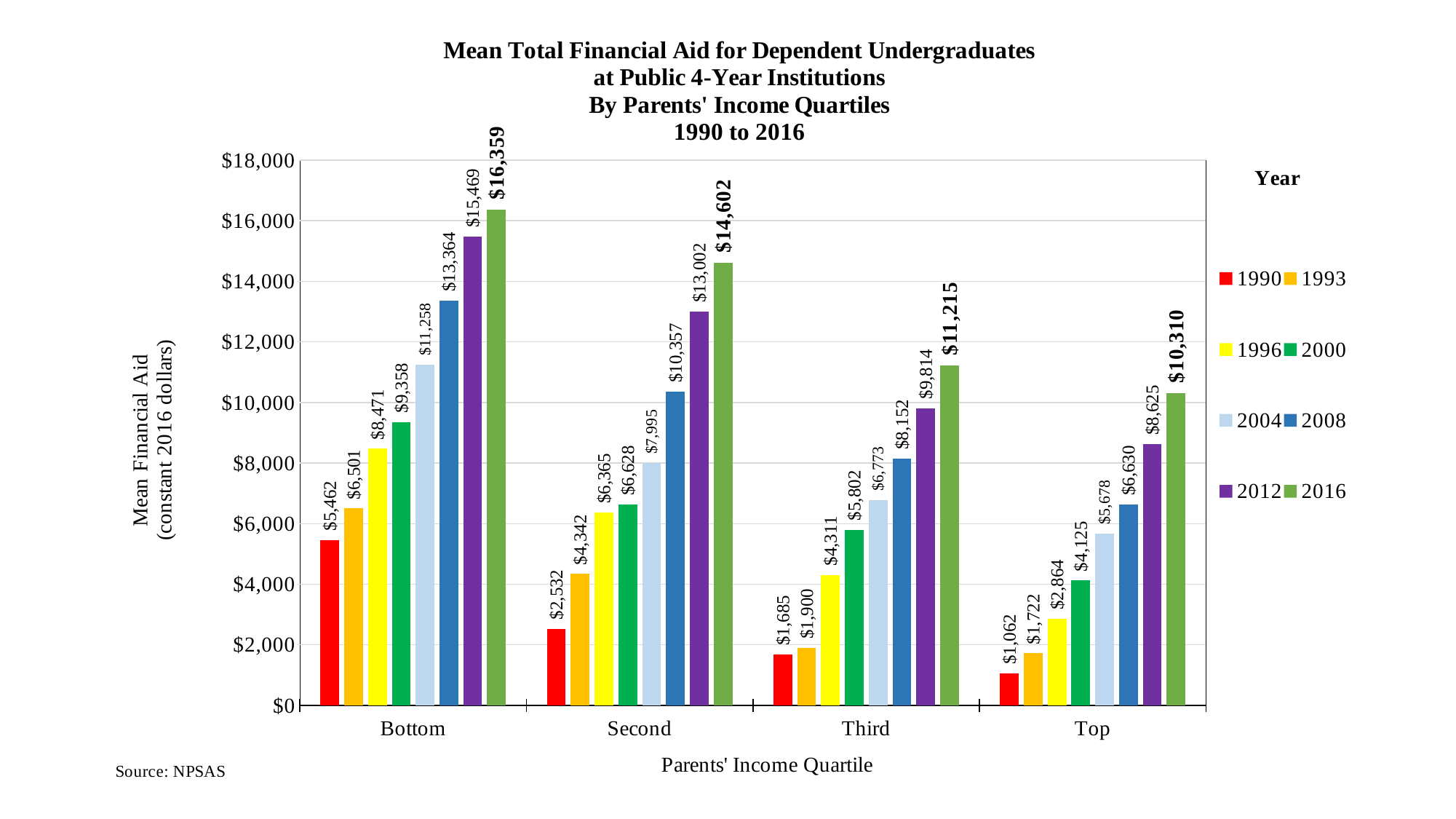
What is the mean total financial aid for the Second income quartile in 2008? $10,357 What kind of chart is shown on the slide? Bar chart How many years does the legend list? 8 Which income quartile has the highest mean financial aid in 2016? Bottom Is the 2012 value for the Second income quartile greater or less than $12,000? greater How many income quartile categories are shown on the x axis? 4 Which income quartile has the lowest mean financial aid in 1990? Top What is the mean total financial aid for the Bottom income quartile in 2016? $16,359 What is the difference between the 2016 and 1990 values for the Third income quartile? $9,530 Which is larger: the 2004 value for the Bottom quartile or the 2016 value for the Top quartile? Bottom quartile in 2004 Within the Top income quartile, do the values rise or fall from 1990 to 2016? Rise What is the mean total financial aid for the Top income quartile in 1990? $1,062